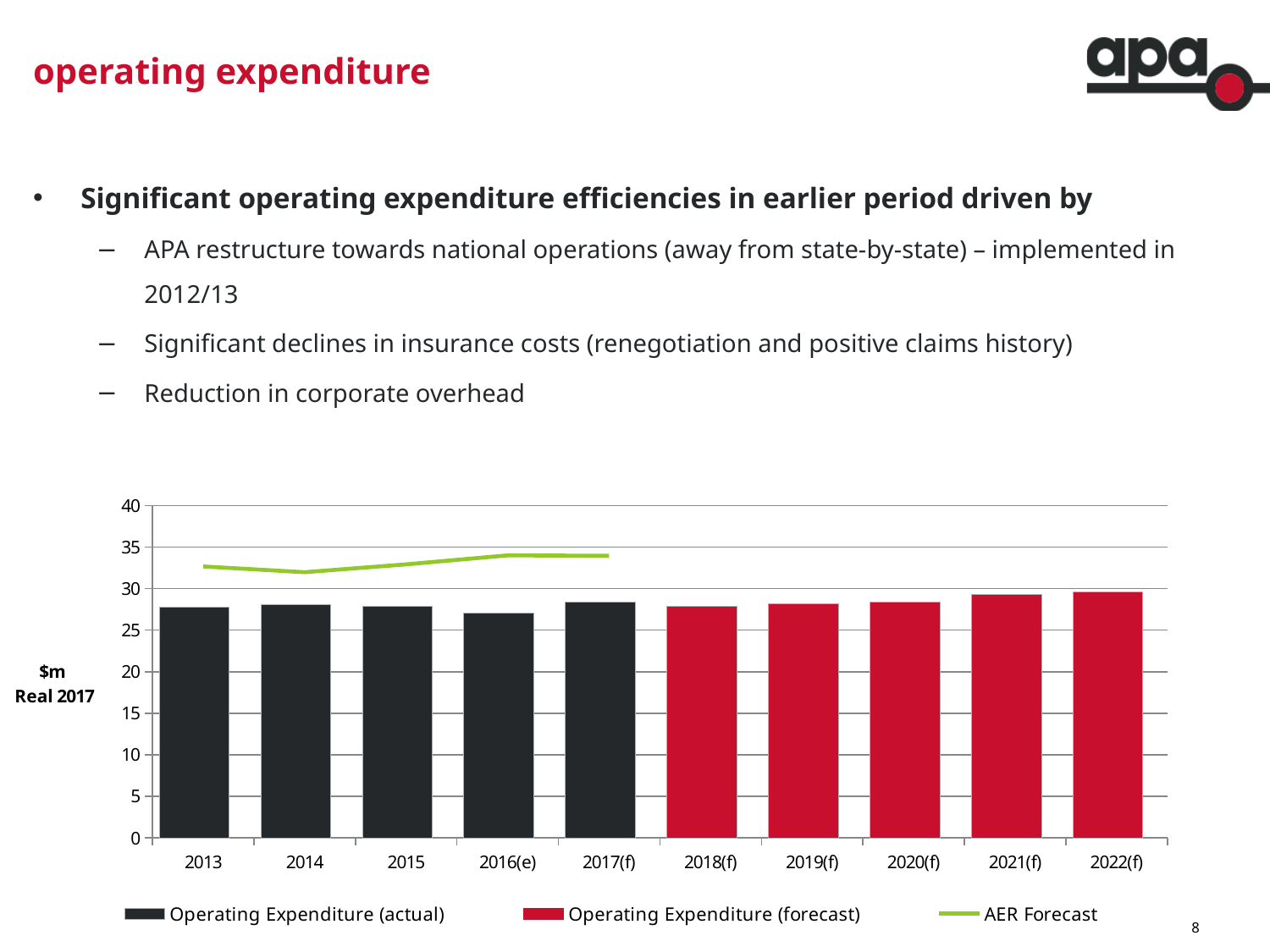
Is the operating expenditure value for 2016(e) greater or less than 30? less What unit is shown on the y axis label of the chart? $m Real 2017 What kind of chart is shown on the slide? combination bar and line chart In 2014, which is higher: the AER Forecast line or the Operating Expenditure (actual) bar? AER Forecast Do the Operating Expenditure (forecast) bars rise or fall from 2018(f) to 2022(f)? rise Which is larger, the operating expenditure bar for 2016(e) or for 2017(f)? 2017(f) Which year has the lowest operating expenditure bar? 2016(e) Is the AER Forecast value for 2016(e) greater or less than 30? greater Which year has the highest operating expenditure bar? 2022(f) How many years are shown on the x axis of the chart? 10 How many series does the chart legend list? 3 Is the operating expenditure value for 2013 greater or less than 25? greater